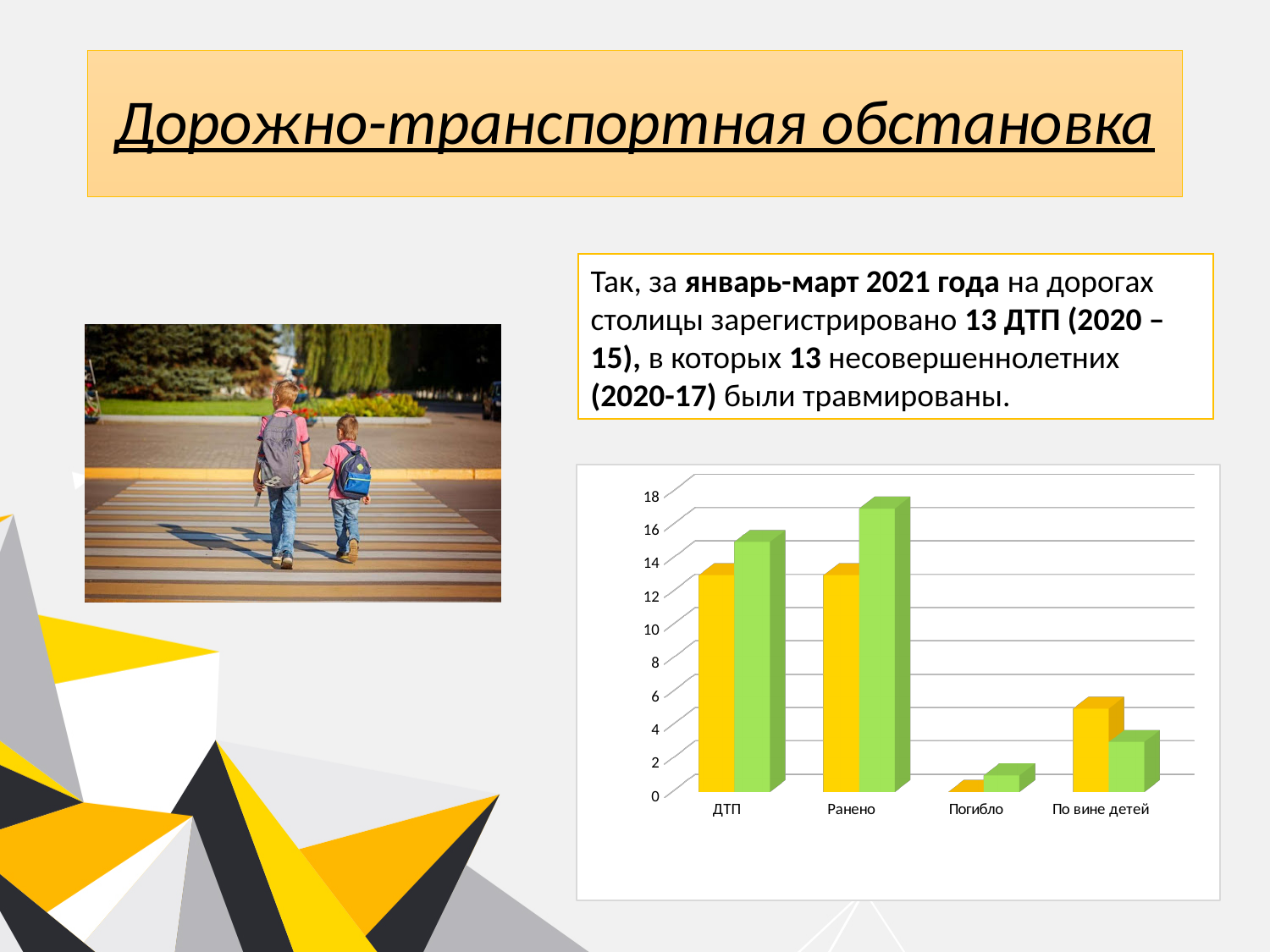
Is the green bar for По вине детей greater or less than 6? less Which category has the tallest bar in the chart? Ранено Is the green bar for Ранено greater or less than 14? greater For По вине детей, which bar is taller, the yellow one or the green one? the yellow one Is the yellow bar for ДТП greater or less than 10? greater Which category has the lowest bars in the chart? Погибло What two colours are used for the bars in the chart? yellow and green How many categories are shown on the x axis of the chart? 4 Which category has taller bars, ДТП or По вине детей? ДТП What kind of chart is shown on the slide? bar chart